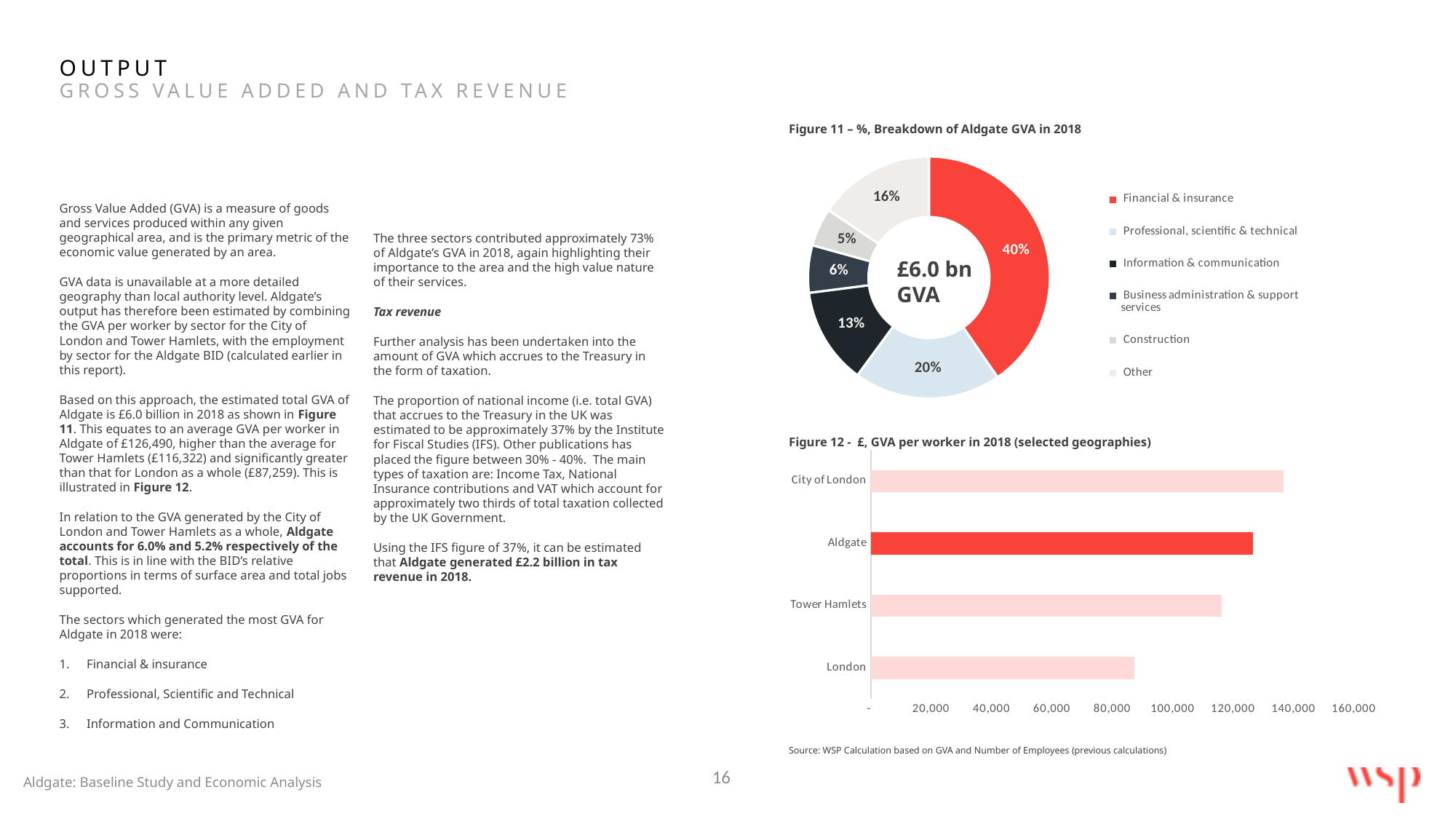
In Figure 12, which geography has the highest GVA per worker? City of London In Figure 11, how many percentage points larger is the Professional, scientific & technical share than the Information & communication share? 7 percentage points In Figure 11, what share of Aldgate GVA in 2018 is Financial & insurance? 40% What text is shown in the centre of the donut in Figure 11? £6.0 bn GVA What kind of chart is Figure 12 - £, GVA per worker in 2018 (selected geographies)? bar chart How many geographies are plotted in Figure 12? 4 In Figure 11, which sector has the largest share of Aldgate GVA? Financial & insurance In Figure 12, is the value for London greater or less than 100,000? less What kind of chart is Figure 11 – %, Breakdown of Aldgate GVA in 2018? pie chart In Figure 11, what percentage is shown for Construction? 5% In Figure 11, which sector has the smallest share of Aldgate GVA? Construction How many sectors are listed in the legend of Figure 11? 6